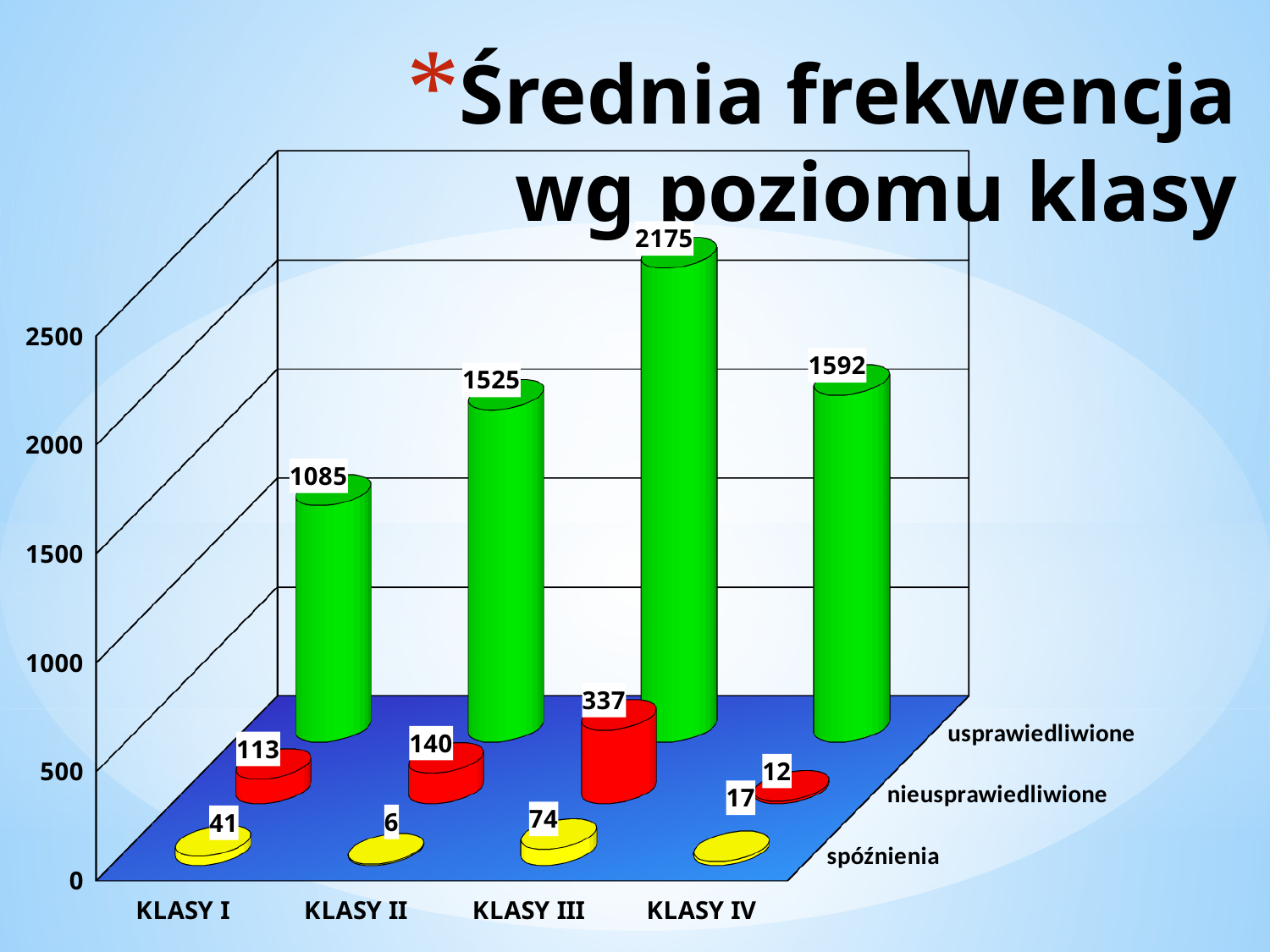
Is the usprawiedliwione value for KLASY IV greater or less than 1500? greater Which class has the highest usprawiedliwione value? KLASY III What is the title of the slide? Średnia frekwencja wg poziomu klasy What is the difference between the usprawiedliwione values for KLASY III and KLASY I? 1090 How many series does the chart show? 3 What is the spóźnienia value for KLASY IV? 17 Which class has the lowest spóźnienia value? KLASY II Which is larger, the nieusprawiedliwione value for KLASY III or for KLASY I? KLASY III How many classes are shown on the x axis? 4 What kind of chart is shown on the slide? bar chart What is the nieusprawiedliwione value for KLASY II? 140 What is the usprawiedliwione value for KLASY III? 2175